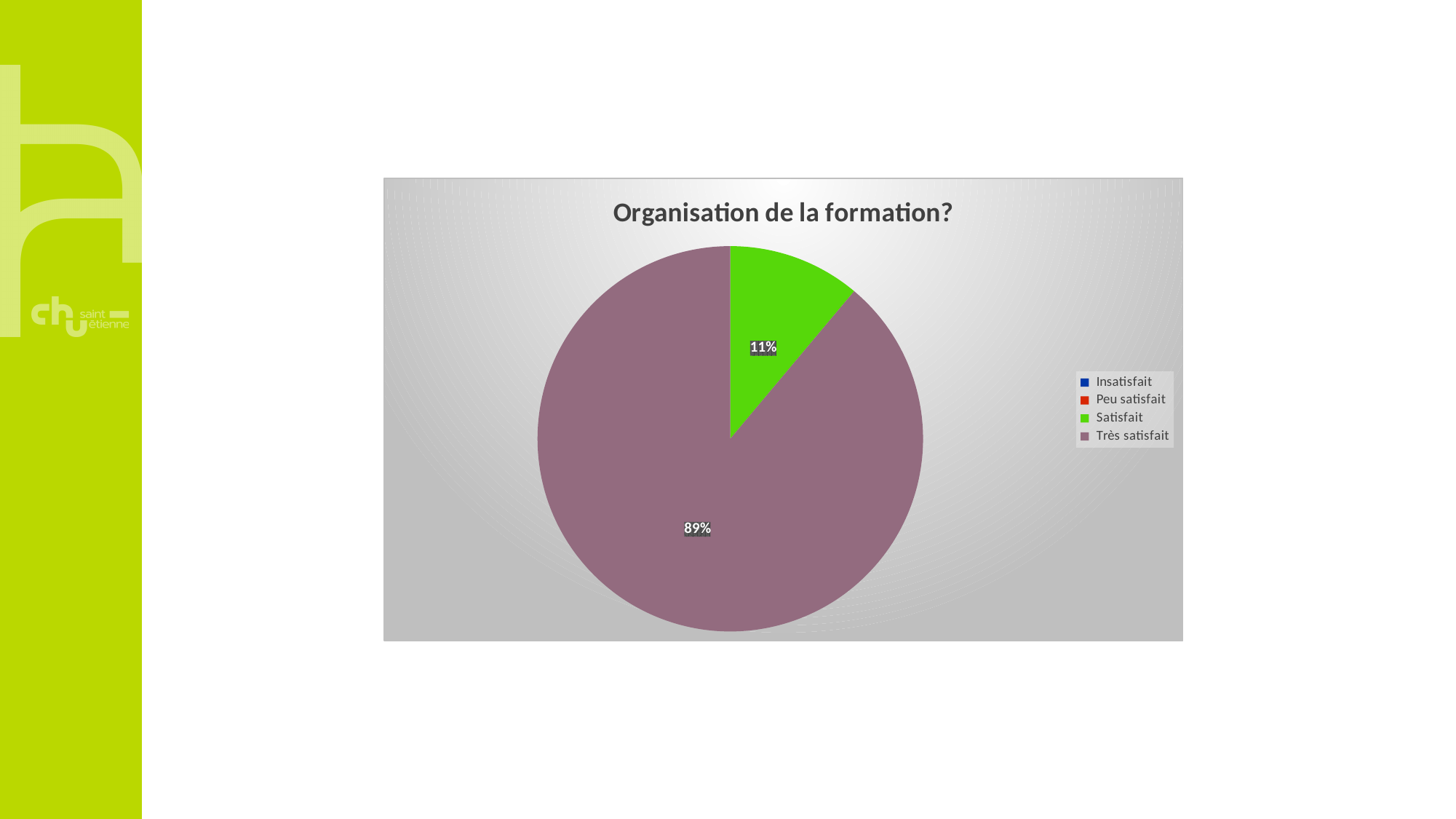
Which is larger, the Satisfait slice or the Très satisfait slice? Très satisfait What colour is the Très satisfait slice? purple What is the title of the chart? Organisation de la formation? How many entries does the legend list? 4 What is the difference between the Très satisfait and Satisfait shares? 78% What kind of chart is shown on the slide? pie chart How many slices are visible in the pie? 2 What share of the pie is labelled for Satisfait? 11% What share of the pie is labelled for Très satisfait? 89% Which category has the largest slice of the pie? Très satisfait